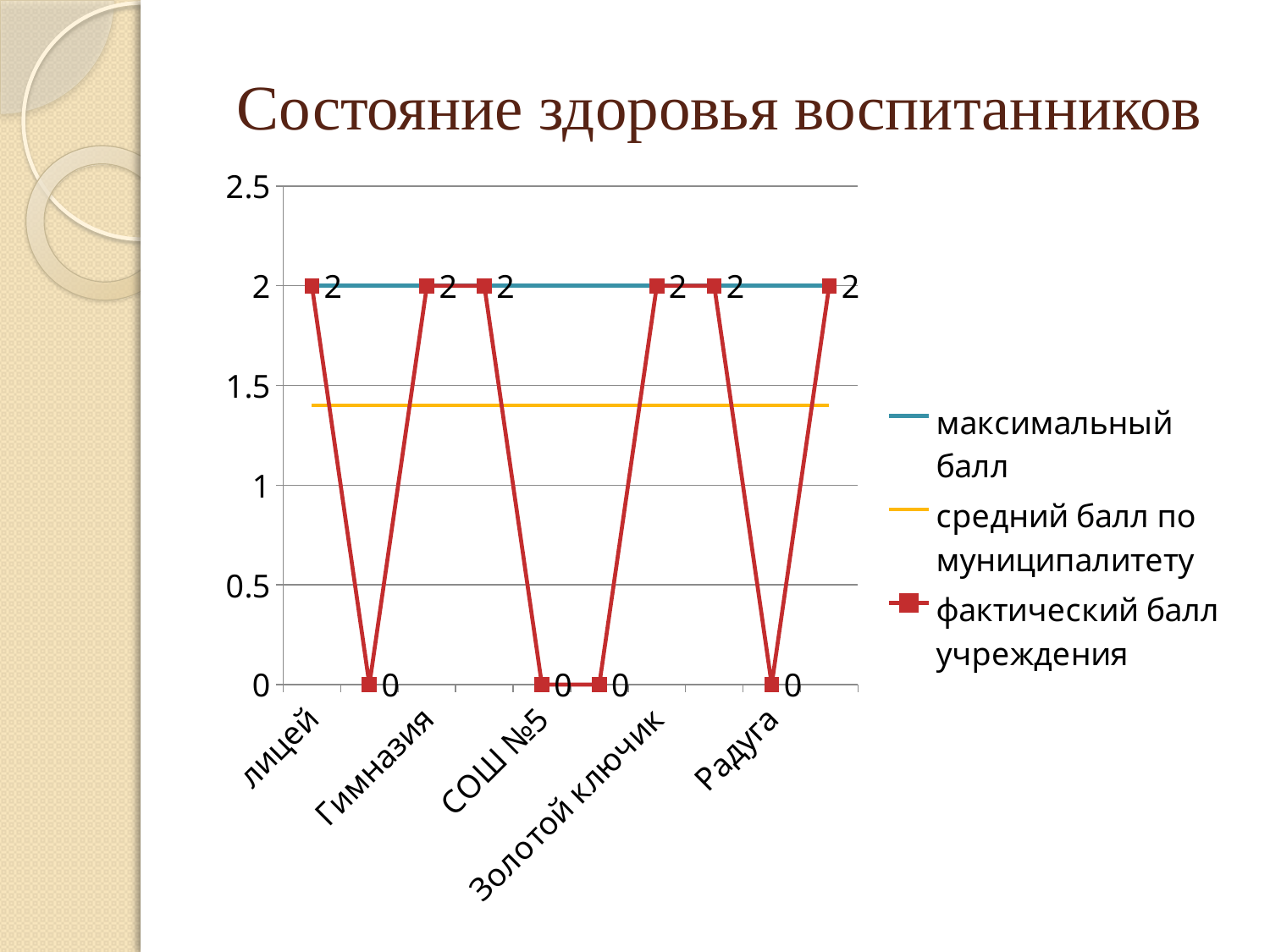
What is the title of the chart? Состояние здоровья воспитанников What kind of chart is shown on the slide? line chart What is the фактический балл учреждения value for Золотой ключик? 2 What is the фактический балл учреждения value for СОШ №5? 0 What is the highest value reached by the фактический балл учреждения line? 2 Is the средний балл по муниципалитету line greater or less than 1? greater What is the value of the максимальный балл line? 2 What is the фактический балл учреждения value for лицей? 2 Is the средний балл по муниципалитету line greater or less than 1.5? less What is the фактический балл учреждения value for Радуга? 0 How many series does the legend list? 3 How many data points are marked on the фактический балл учреждения line? 10